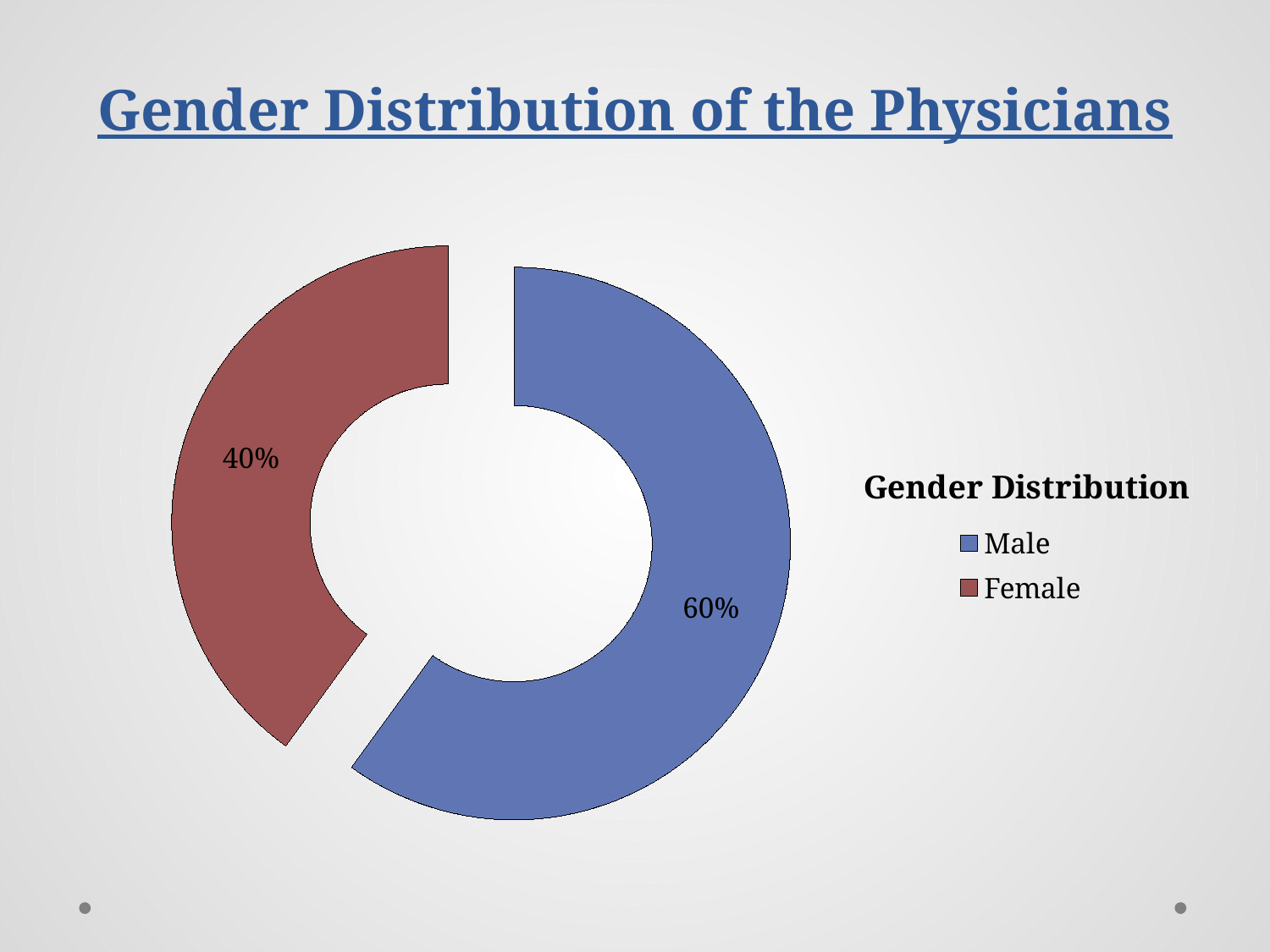
Which gender has the smaller share of physicians? Female Which colour represents Female in the chart? Red What percentage of the physicians are male? 60% How many categories does the chart show? 2 What kind of chart is shown on the slide? Doughnut (pie) chart Is the share of male physicians larger or smaller than the share of female physicians? larger What percentage of the physicians are female? 40% How many entries does the legend list? 2 Which gender has the larger share of physicians? Male What is the difference in percentage points between the male and female shares? 20 Is the share of female physicians greater or less than 50%? less What is the title of the chart's legend? Gender Distribution